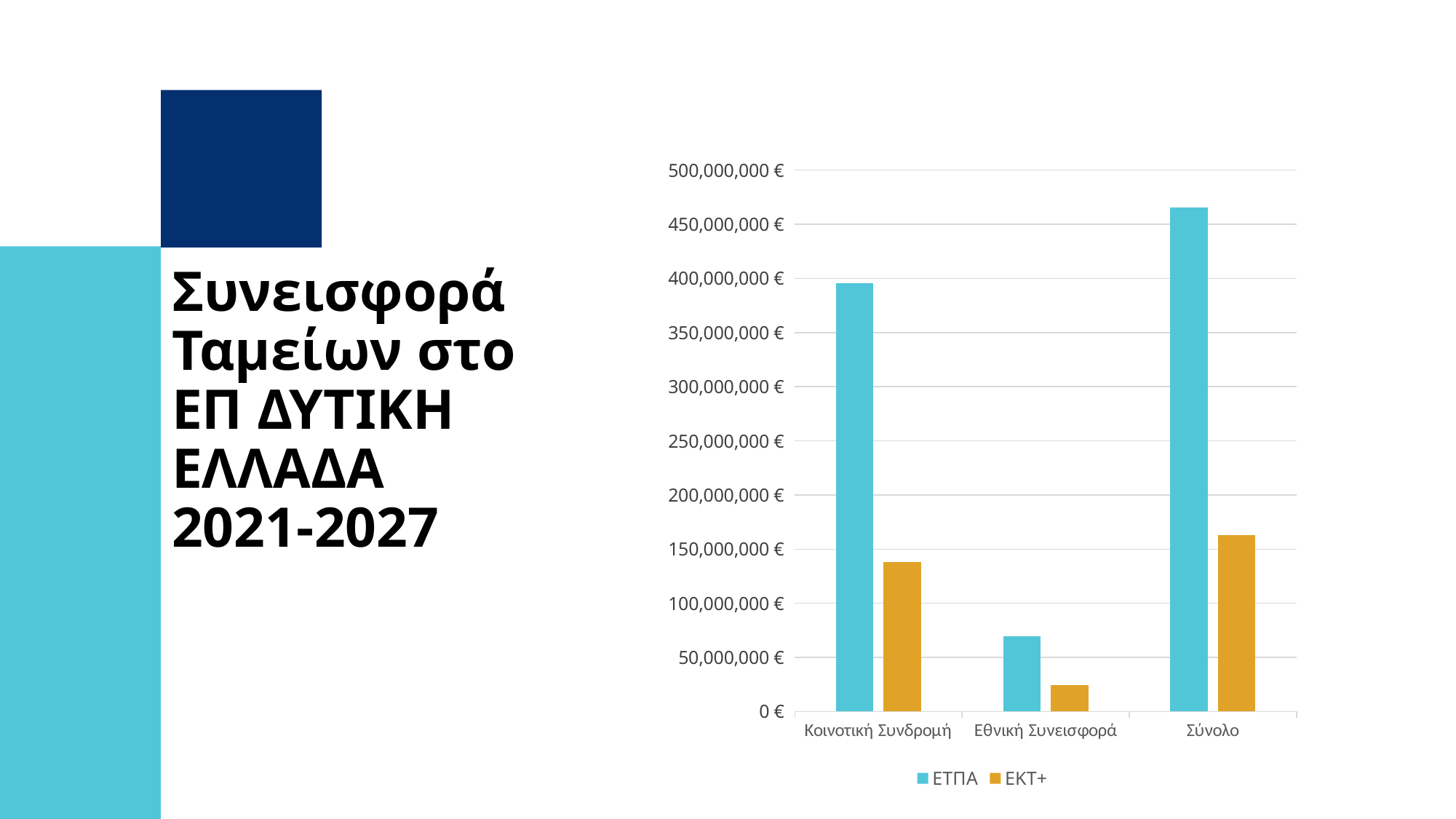
How many categories are shown on the x axis of the chart? 3 How many series does the chart's legend list? 2 Which series is shown in orange in the chart's legend? ΕΚΤ+ Which category has the lowest ΕΚΤ+ value? Εθνική Συνεισφορά Is the ΕΚΤ+ value for Κοινοτική Συνδρομή greater or less than 150,000,000 €? less Which category has the highest ΕΤΠΑ value? Σύνολο Is the ΕΤΠΑ value for Εθνική Συνεισφορά greater or less than 50,000,000 €? greater Is the ΕΚΤ+ value for Εθνική Συνεισφορά greater or less than 50,000,000 €? less What kind of chart is shown on the slide? Bar chart In the Σύνολο category, which series has the larger value, ΕΤΠΑ or ΕΚΤ+? ΕΤΠΑ